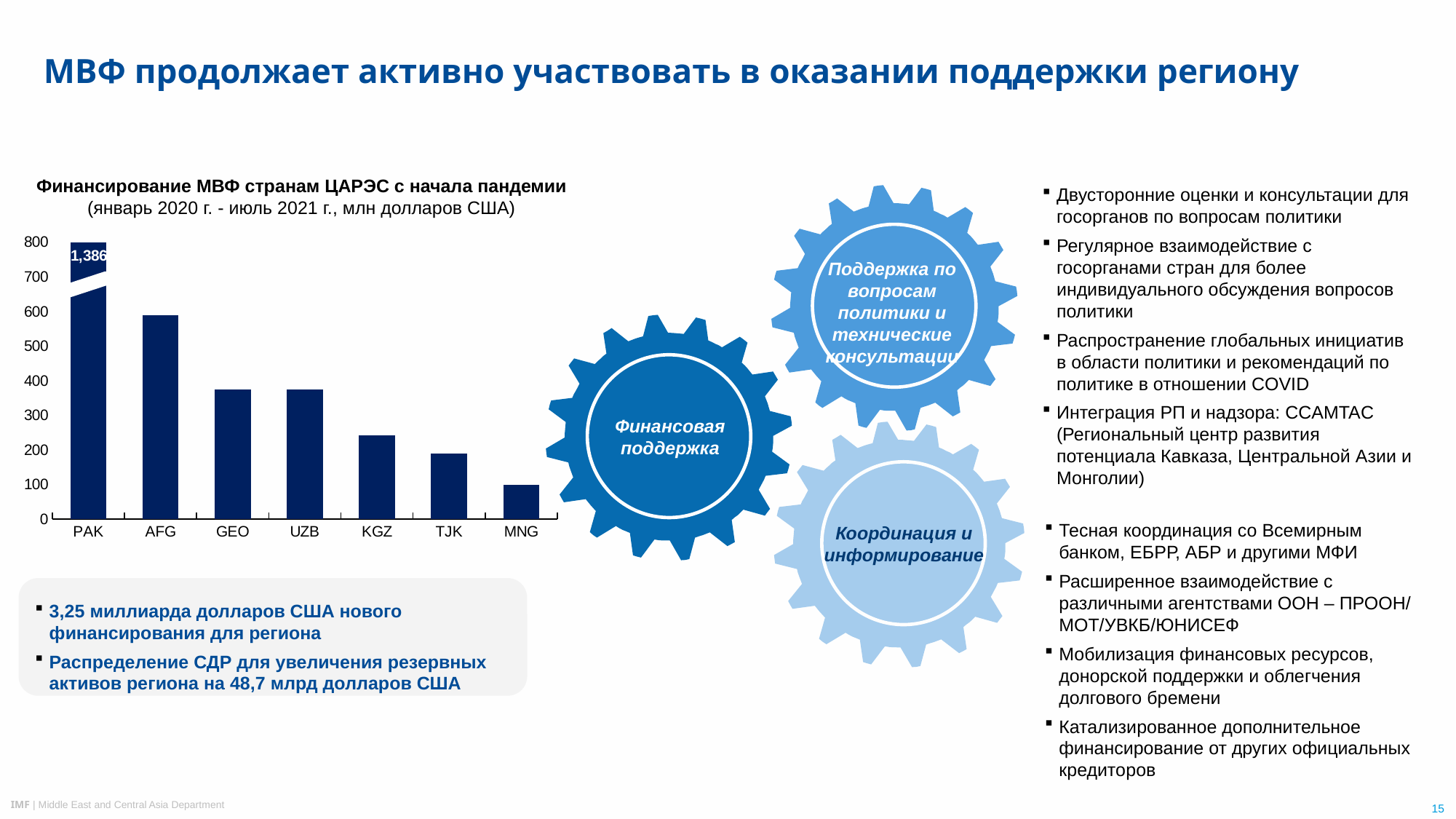
Which country has the lowest value in the chart? MNG What is the value for PAK in the chart? 1,386 Which is larger, the value for AFG or the value for GEO? AFG How many countries are shown in the chart? 7 Do the values rise or fall from left to right along the x axis? Fall Is the value for MNG greater or less than 200? less Which is larger, the value for KGZ or the value for TJK? KGZ What kind of chart is shown on the slide? Bar chart What is the title of the chart? Финансирование МВФ странам ЦАРЭС с начала пандемии Is the value for TJK greater or less than 200? less Is the value for AFG greater or less than 500? greater Which country has the highest value in the chart? PAK